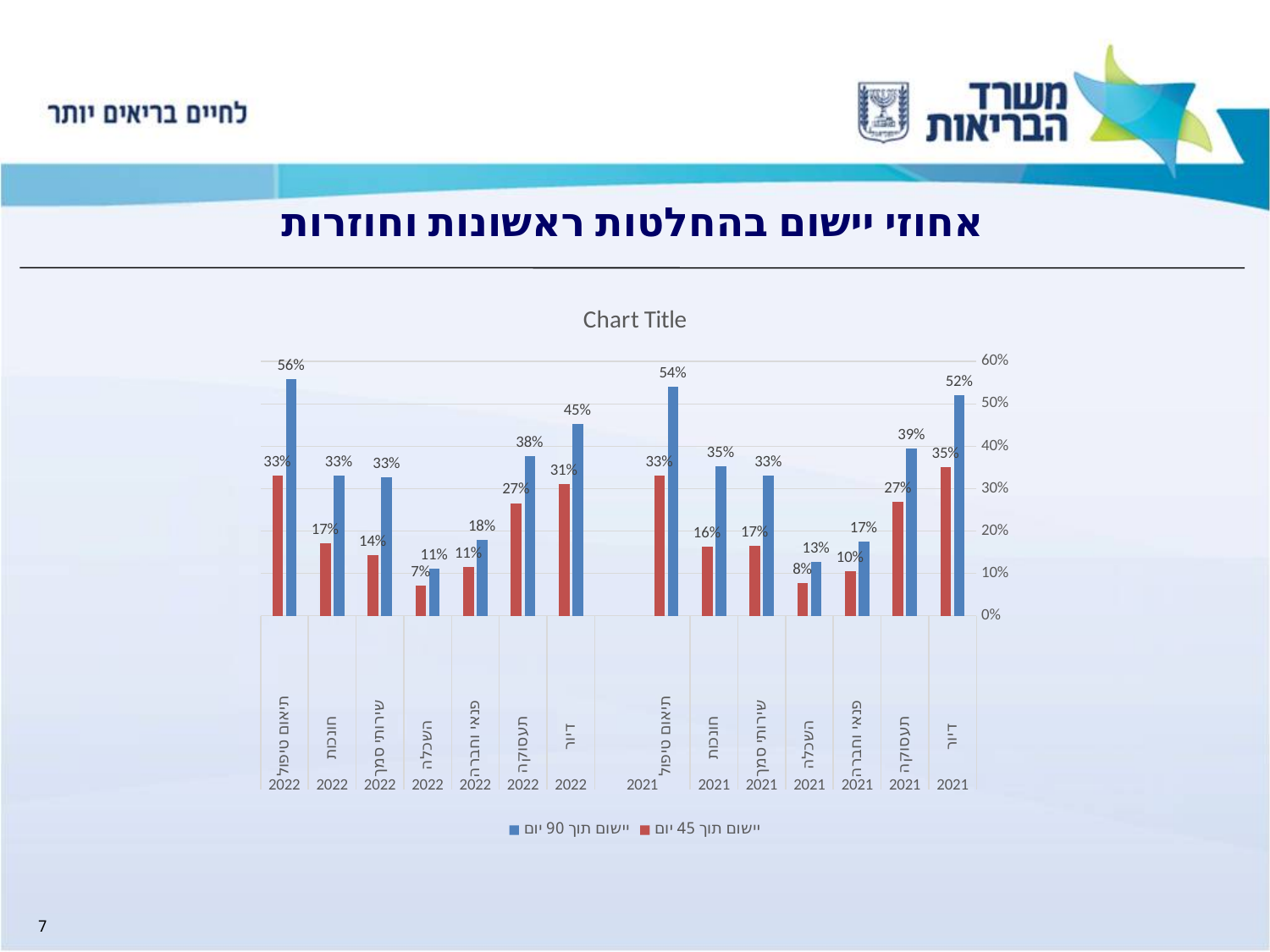
Which is larger: the יישום תוך 90 יום value for תעסוקה 2022 or for תעסוקה 2021? תעסוקה 2021 What is the value of יישום תוך 45 יום for השכלה 2022? 7% What is the difference between the יישום תוך 90 יום and יישום תוך 45 יום values for דיור 2022? 14% How many series does the legend list? 2 What is the value of יישום תוך 90 יום for תיאום טיפול 2022? 56% Which category has the highest value for יישום תוך 90 יום? תיאום טיפול 2022 How many categories are shown along the x axis? 14 What is the value of יישום תוך 90 יום for דיור 2021? 52% Which category has the lowest value for יישום תוך 45 יום? השכלה 2022 What kind of chart is shown on the slide? bar chart What is the title shown above the chart? Chart Title What is the value of יישום תוך 45 יום for דיור 2021? 35%